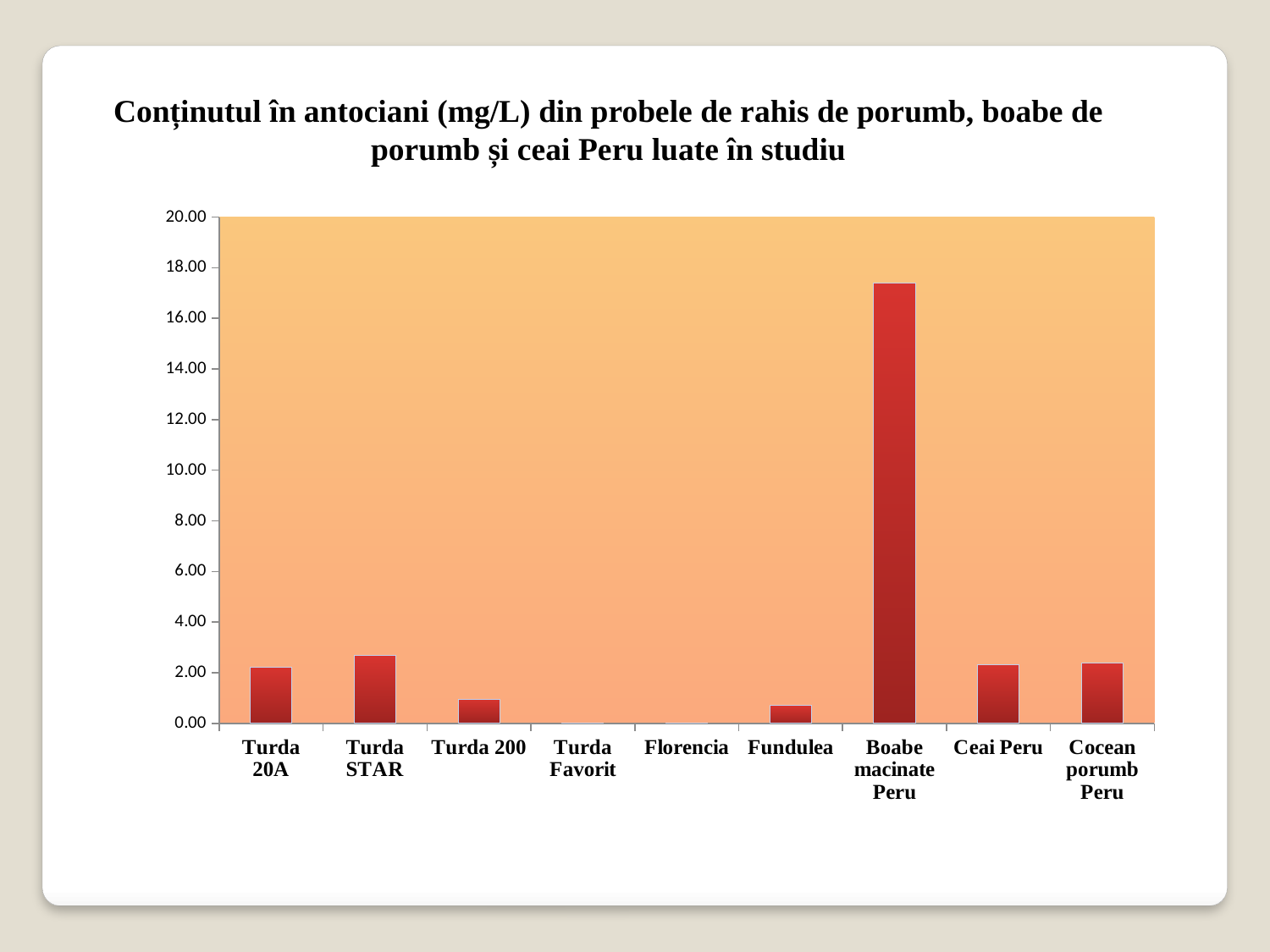
Which is larger, the value for Boabe macinate Peru or the value for Ceai Peru? Boabe macinate Peru Is the value for Turda STAR greater or less than 2.00? greater Is the value for Boabe macinate Peru greater or less than 18.00? less How many categories are shown on the x axis of the chart? 9 Is the value for Turda STAR greater or less than 4.00? less Which is larger, the value for Turda STAR or the value for Turda 200? Turda STAR Which category has the highest anthocyanin content in the chart? Boabe macinate Peru What kind of chart is shown on the slide? bar chart In what unit is the anthocyanin content expressed according to the chart title? mg/L